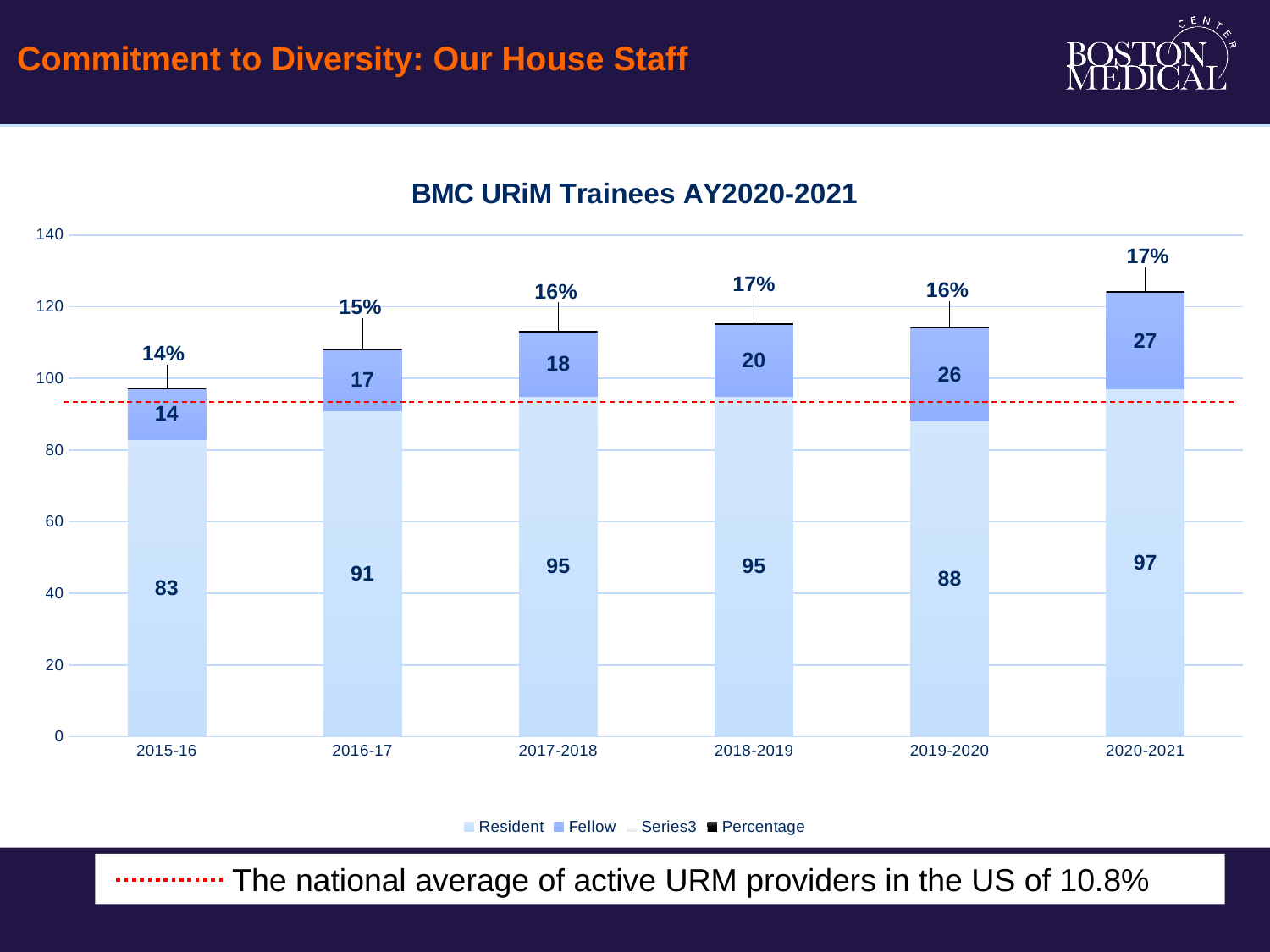
What percentage is labelled above the 2016-17 bar? 15% What is the difference between the Resident values for 2020-2021 and 2015-16? 14 What is the title of the chart? BMC URiM Trainees AY2020-2021 Which academic year has the highest Fellow value? 2020-2021 What type of chart is shown on the slide? bar chart How many academic years are shown on the x axis? 6 What is the Fellow value for 2019-2020? 26 Which academic year has the lowest Resident value? 2015-16 What is the Resident value for 2017-2018? 95 What is the total of the stacked bar (Resident plus Fellow) for 2018-2019? 115 How many series does the legend list? 4 Is the Fellow value larger for 2016-17 or for 2019-2020? 2019-2020